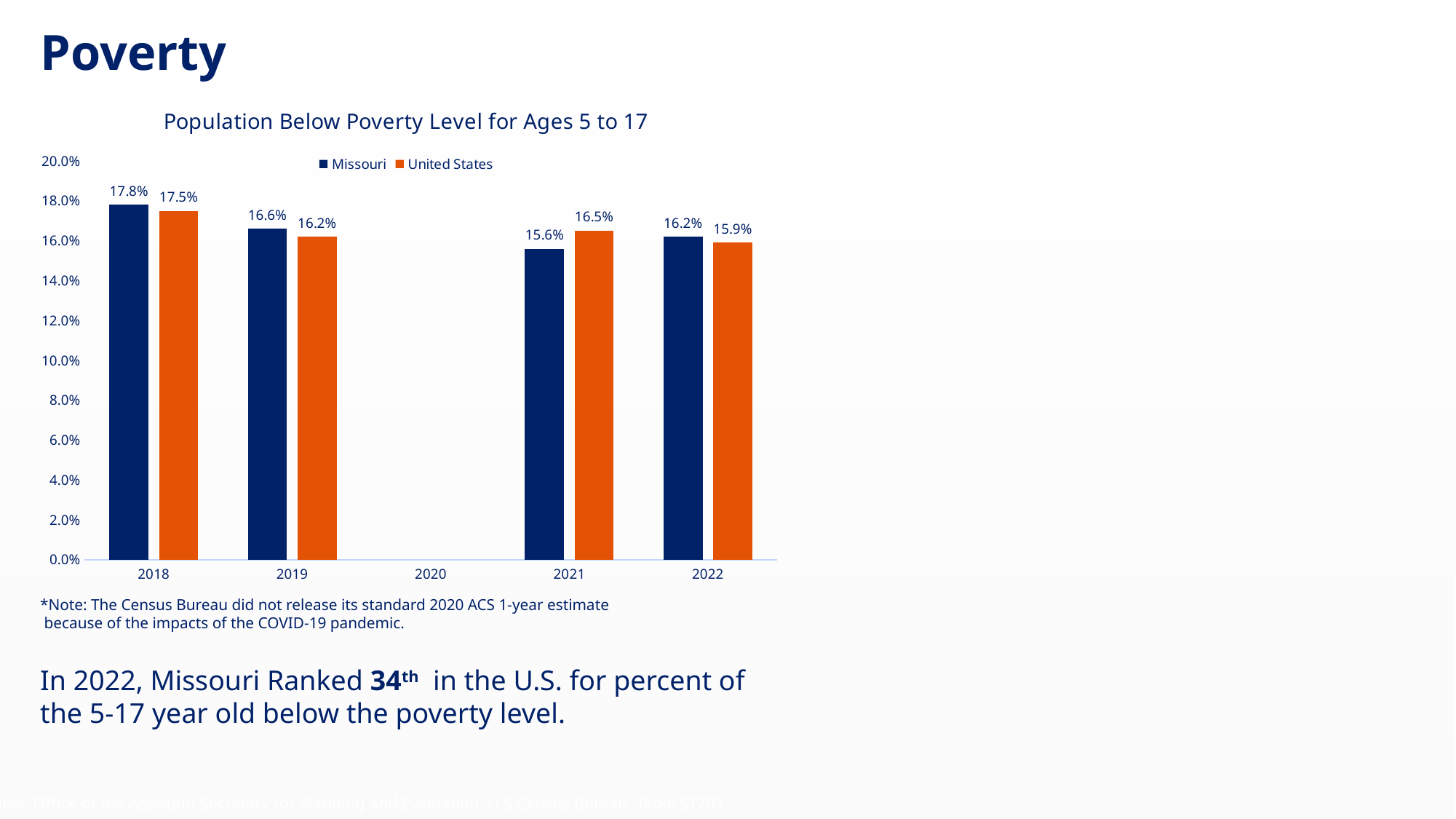
What is the Missouri value for 2018? 17.8% Is the United States value for 2018 greater or less than 16.0%? greater What is the United States value for 2021? 16.5% How many series does the legend list? 2 In which year is the Missouri value highest? 2018 In which year is the Missouri value lowest? 2021 What is the difference between the Missouri and United States values in 2019? 0.4% What is the Missouri value for 2022? 16.2% In 2021, which is larger, the Missouri value or the United States value? United States What is the title of the chart? Population Below Poverty Level for Ages 5 to 17 How many years are shown on the x axis? 5 What kind of chart is shown? bar chart